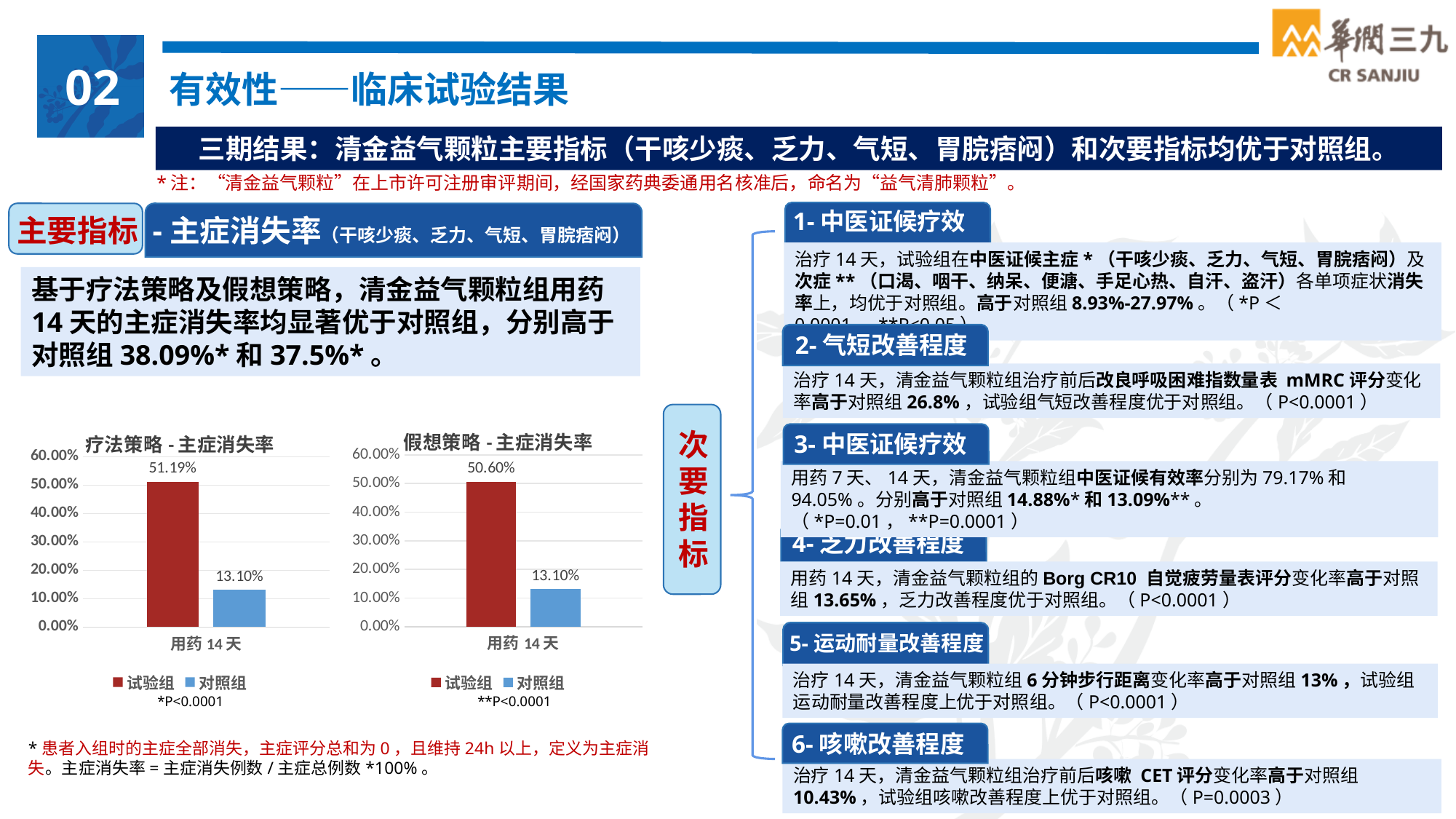
In the chart titled 假想策略 - 主症消失率, what is the value for 试验组? 50.60% In the chart titled 疗法策略 - 主症消失率, what is the value for 对照组? 13.10% In the chart titled 疗法策略 - 主症消失率, what is the label on the x axis category? 用药 14 天 In the chart titled 疗法策略 - 主症消失率, what is the value for 试验组? 51.19% In the chart titled 假想策略 - 主症消失率, what is the value for 对照组? 13.10% In the chart titled 假想策略 - 主症消失率, which series has the lower value? 对照组 What kind of chart is the chart titled 假想策略 - 主症消失率? bar chart In the chart titled 假想策略 - 主症消失率, what is the difference between the 试验组 and 对照组 values? 37.50% How many series does the legend of the chart titled 疗法策略 - 主症消失率 list? 2 In the chart titled 假想策略 - 主症消失率, is the value for 试验组 greater or less than 40.00%? greater In the chart titled 疗法策略 - 主症消失率, which series has the higher value? 试验组 In the chart titled 疗法策略 - 主症消失率, what is the difference between the 试验组 and 对照组 values? 38.09%